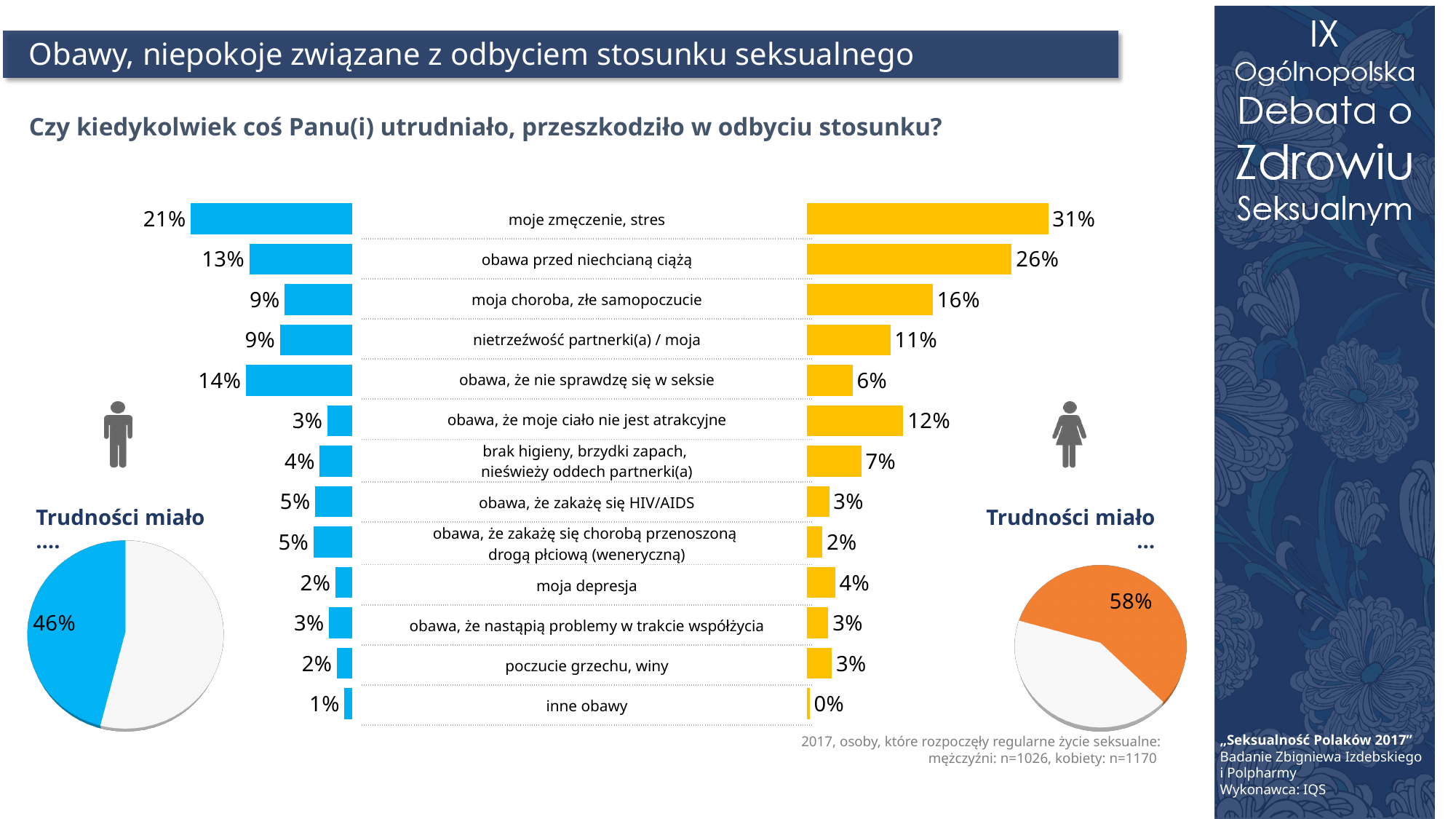
In the yellow bar chart for women, what is the value for 'inne obawy'? 0% What is the difference between the women's and men's values for 'obawa, że moje ciało nie jest atrakcyjne'? 9% What colour are the bars representing men in the bar chart? blue In the right pie chart (women), what share is shown for the orange slice? 58% For 'obawa, że nie sprawdzę się w seksie', which is larger: the men's value or the women's value? the men's value (14%) In the yellow bar chart for women, which category has the highest value? moje zmęczenie, stres In the left pie chart (men), what share is shown for the blue slice? 46% In the blue bar chart for men, which category has the lowest value? inne obawy What kind of chart is used to show the categories in the middle of the slide? bar chart In the yellow bar chart for women, what is the value for 'obawa przed niechcianą ciążą'? 26% In the blue bar chart for men, what is the value for 'moje zmęczenie, stres'? 21% How many categories are listed in the bar chart? 13